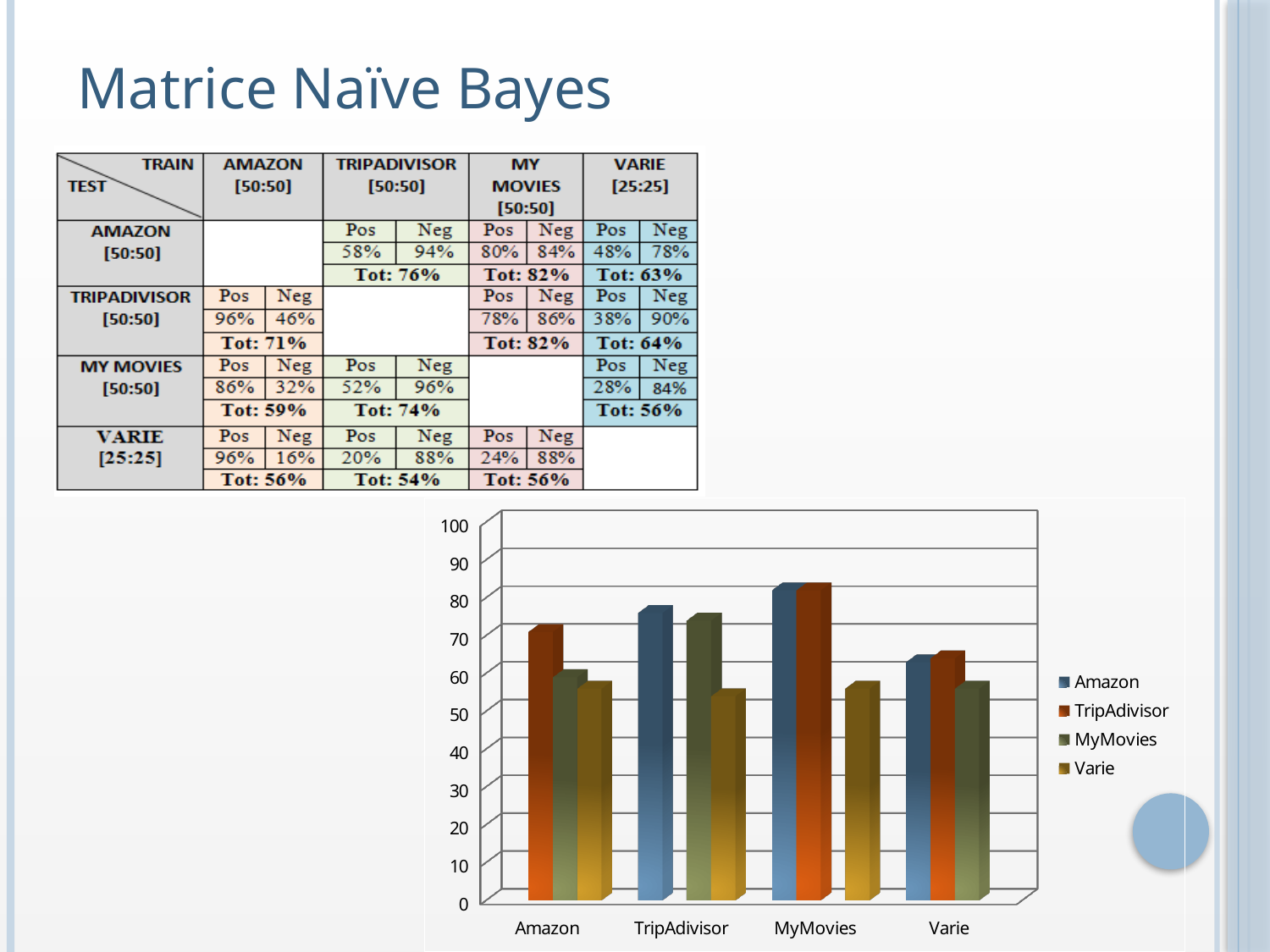
In the bar chart, is the value of the MyMovies series for the Varie category greater or less than 70? less How many series does the legend of the bar chart list? 4 In the bar chart, which series has the highest bar for the Amazon category? TripAdivisor In the bar chart, is the value of the TripAdivisor series for the Amazon category greater or less than 60? greater What colour represents the Amazon series in the bar chart's legend? blue In the bar chart, is the value of the Varie series for the TripAdivisor category greater or less than 60? less What kind of chart is shown on the slide? bar chart How many categories are shown on the x axis of the bar chart? 4 In the bar chart, for the TripAdivisor category, which is larger: the Amazon series or the Varie series? Amazon In the bar chart, which series has the lowest bar for the MyMovies category? Varie In the bar chart, which series has the lowest bar for the Varie category? MyMovies